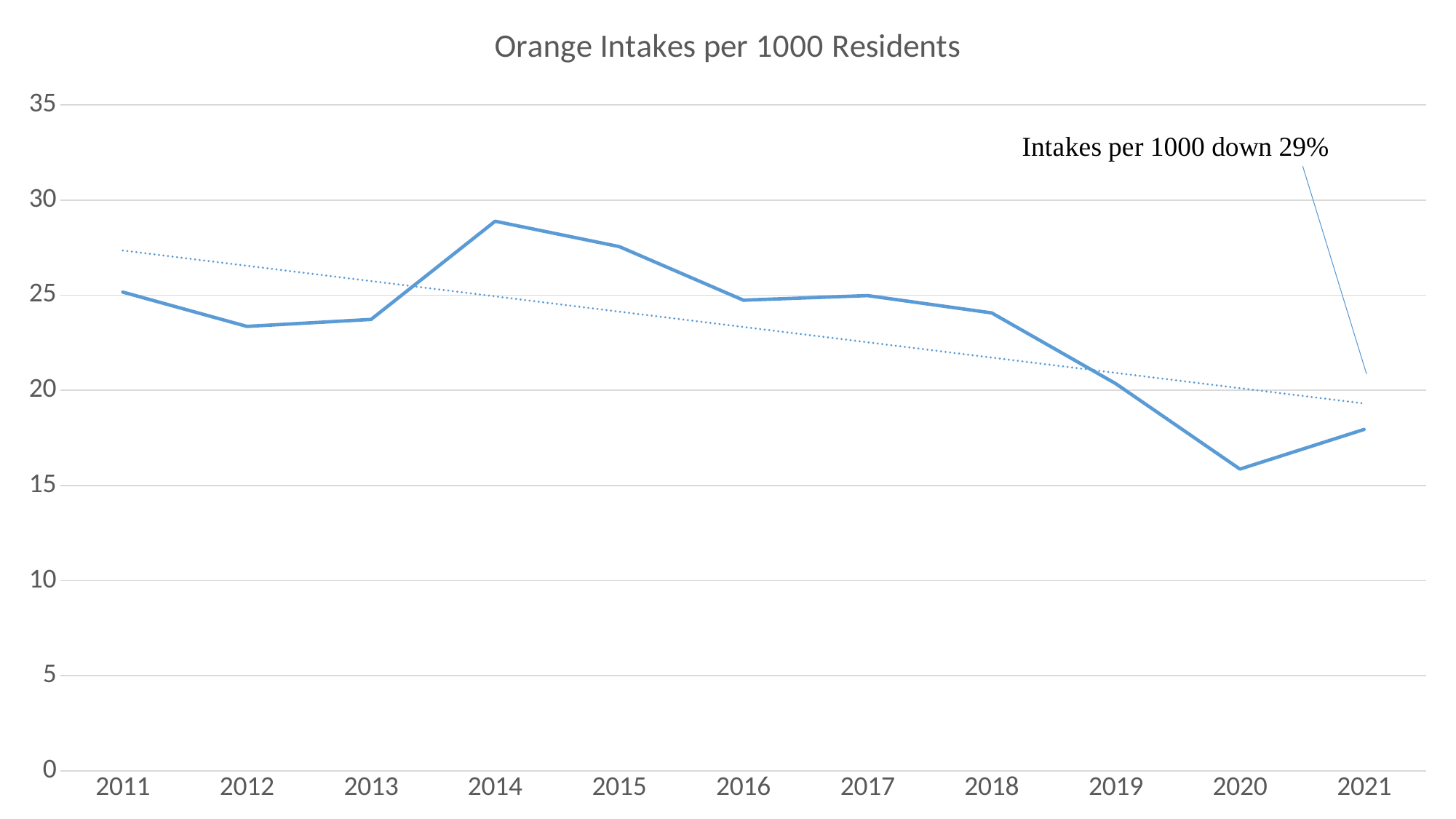
Overall, do the intakes per 1000 residents rise or fall from 2011 to 2021? fall Is the value for 2014 greater or less than 25? greater Is the value for 2020 greater or less than 20? less Which year has the highest intakes per 1000 residents? 2014 What percentage decline does the annotation on the chart state for intakes per 1000? 29% Which year has the lowest intakes per 1000 residents? 2020 Which is larger, the value for 2015 or the value for 2019? 2015 Is the value for 2012 greater or less than 25? less What kind of chart is shown on the slide? line chart How many years are plotted along the x axis? 11 What is the title of the chart? Orange Intakes per 1000 Residents